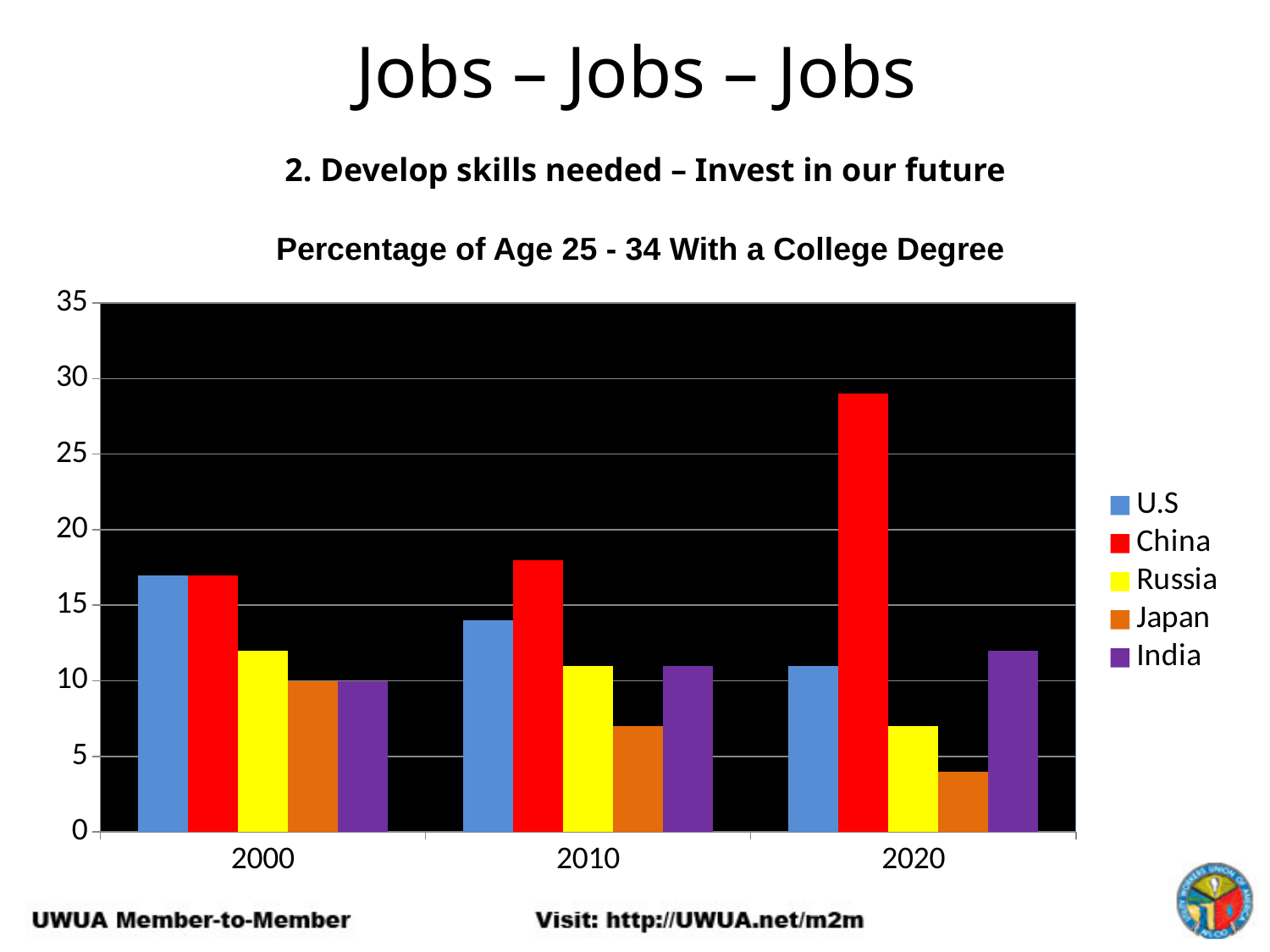
Is the value for U.S in 2000 greater or less than 15? greater Is the value for Japan in 2020 greater or less than 5? less What is the title of the chart? Percentage of Age 25 - 34 With a College Degree Is the value for China in 2020 greater or less than 25? greater What kind of chart is shown on the slide? bar chart How many year categories are shown on the x axis? 3 Does the value for U.S rise or fall from 2000 to 2020? fall How many series does the legend list? 5 Which country has the lowest value in 2020? Japan Which is larger in 2010, the value for China or the value for U.S? China Which country has the lowest value in 2010? Japan Which country has the highest value in 2020? China